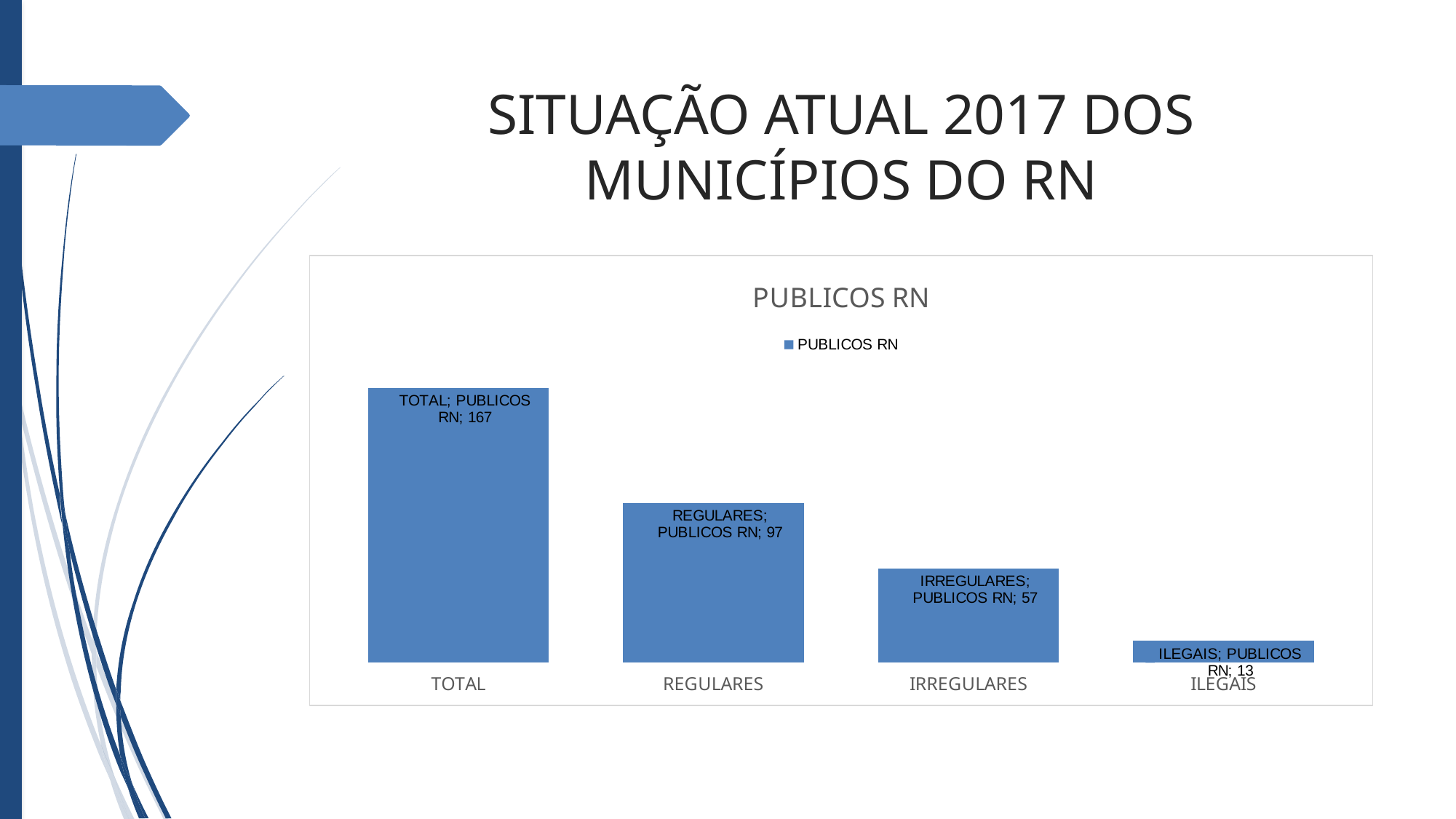
Which category has the highest value? TOTAL What is the title of the chart? PUBLICOS RN What is the value for IRREGULARES? 57 How many categories are shown on the x axis? 4 Which category has the lowest value? ILEGAIS What is the value for REGULARES? 97 What is the value for ILEGAIS? 13 What is the value for TOTAL? 167 What kind of chart is this? bar chart What is the difference between the values for REGULARES and IRREGULARES? 40 Which is larger, the value for IRREGULARES or the value for ILEGAIS? IRREGULARES What is the difference between the values for TOTAL and ILEGAIS? 154